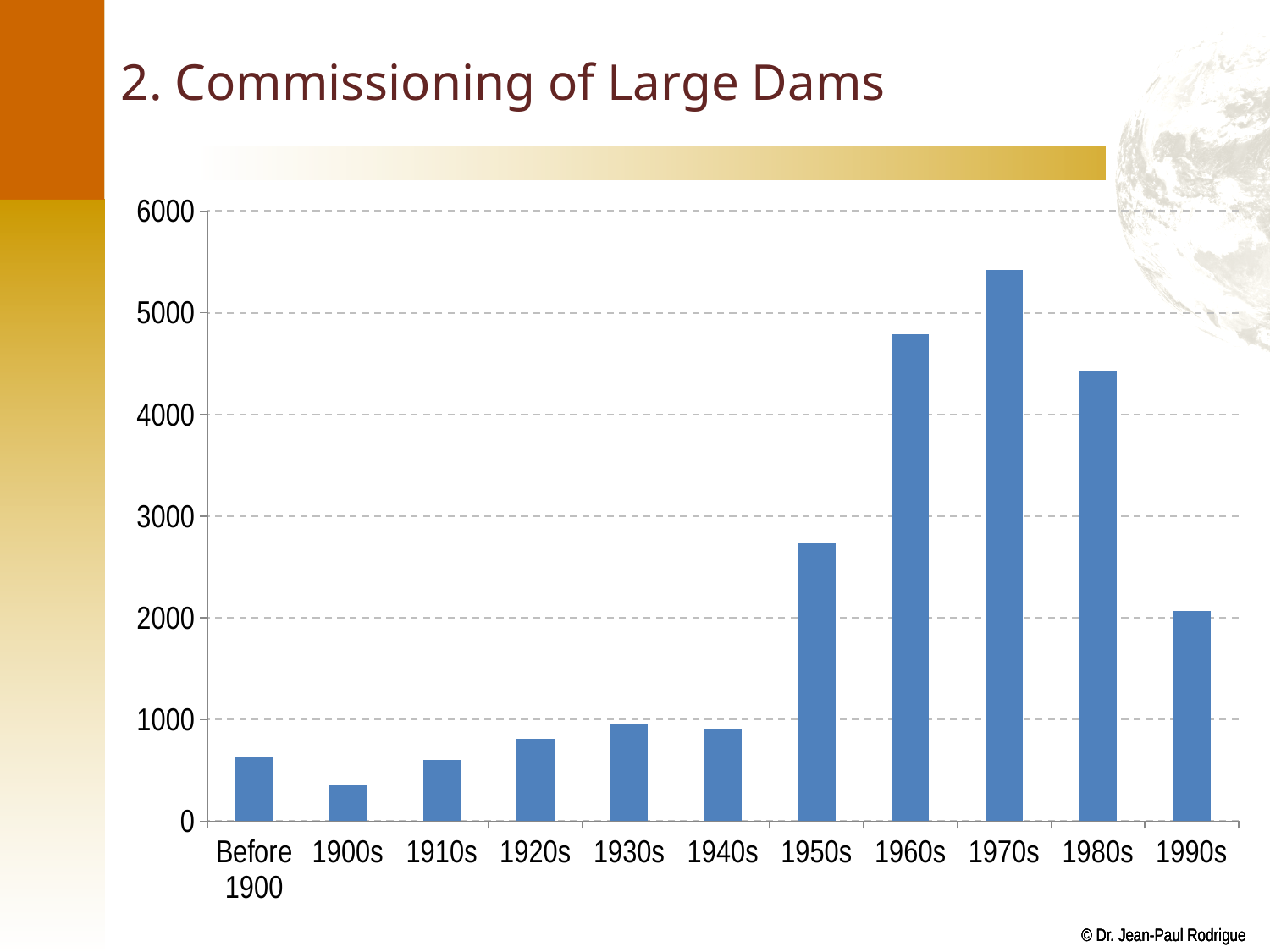
Do the values rise or fall from the 1970s to the 1990s? fall Is the value for the 1960s greater or less than 5000? less Is the value for the 1970s greater or less than 5000? greater What kind of chart is shown on the slide? bar chart Is the value for the 1950s greater or less than 3000? less Which decade has the lowest number of large dams commissioned? 1900s Which is larger, the value for the 1960s or the value for the 1980s? 1960s What is the title of the slide containing the chart? 2. Commissioning of Large Dams How many decade categories are shown on the x axis? 11 Which decade has the highest number of large dams commissioned? 1970s